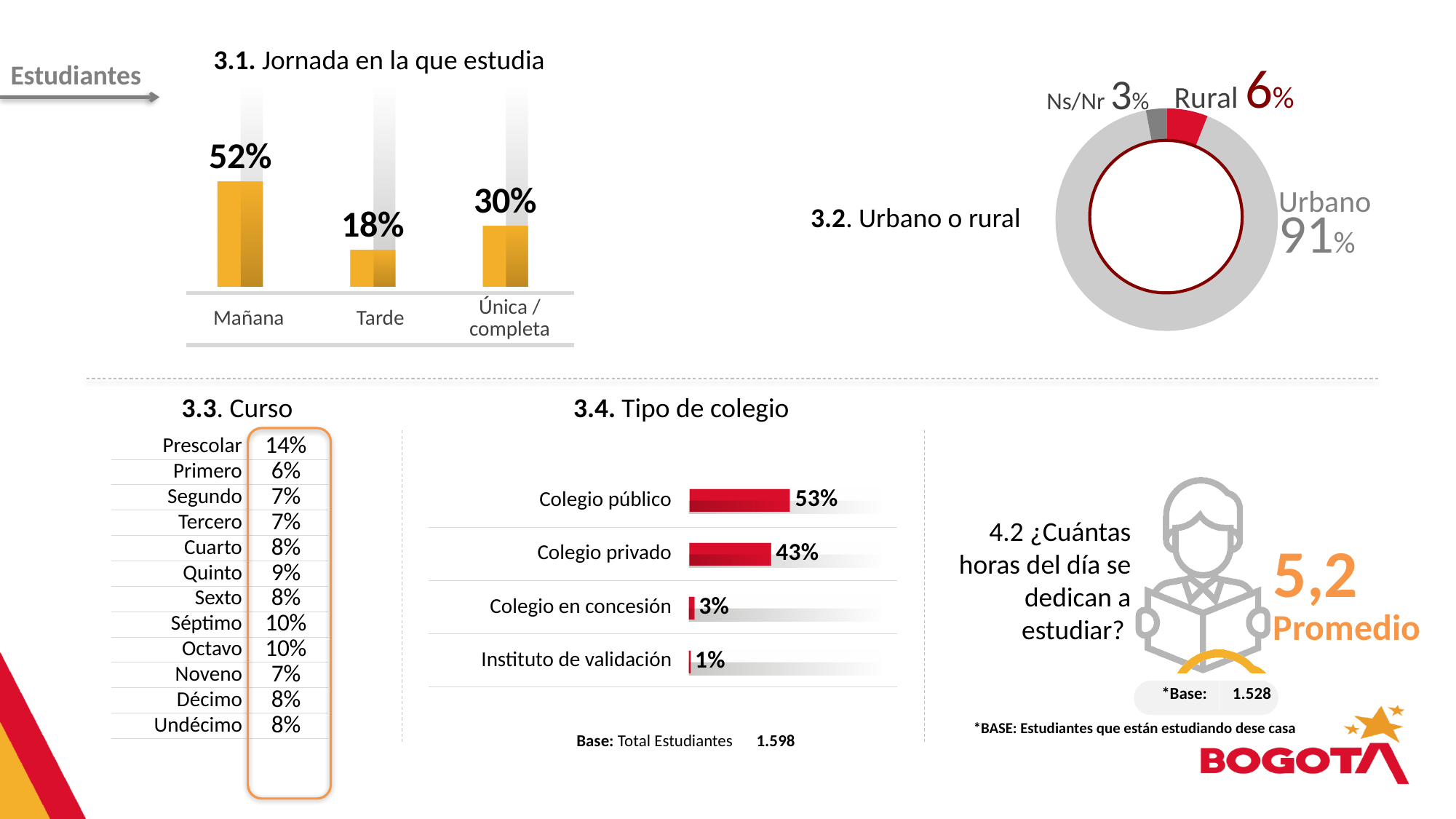
What kind of chart is '3.1. Jornada en la que estudia'? bar chart In the chart '3.4. Tipo de colegio', which category has the highest value? Colegio público In the chart '3.1. Jornada en la que estudia', what is the difference between Mañana and Única / completa? 22% In the chart '3.4. Tipo de colegio', what is the value for Colegio privado? 43% In the chart '3.4. Tipo de colegio', which is larger, Colegio en concesión or Instituto de validación? Colegio en concesión In the chart '3.1. Jornada en la que estudia', which category has the lowest value? Tarde In the chart '3.2. Urbano o rural', what is the value for Urbano? 91% In the chart '3.2. Urbano o rural', how many categories are shown? 3 In the chart '3.4. Tipo de colegio', what is the difference between Colegio público and Colegio privado? 10% In the chart '3.1. Jornada en la que estudia', what is the value for Mañana? 52% In the chart '3.4. Tipo de colegio', how many categories are shown? 4 In the chart '3.2. Urbano o rural', what is the value for Rural? 6%